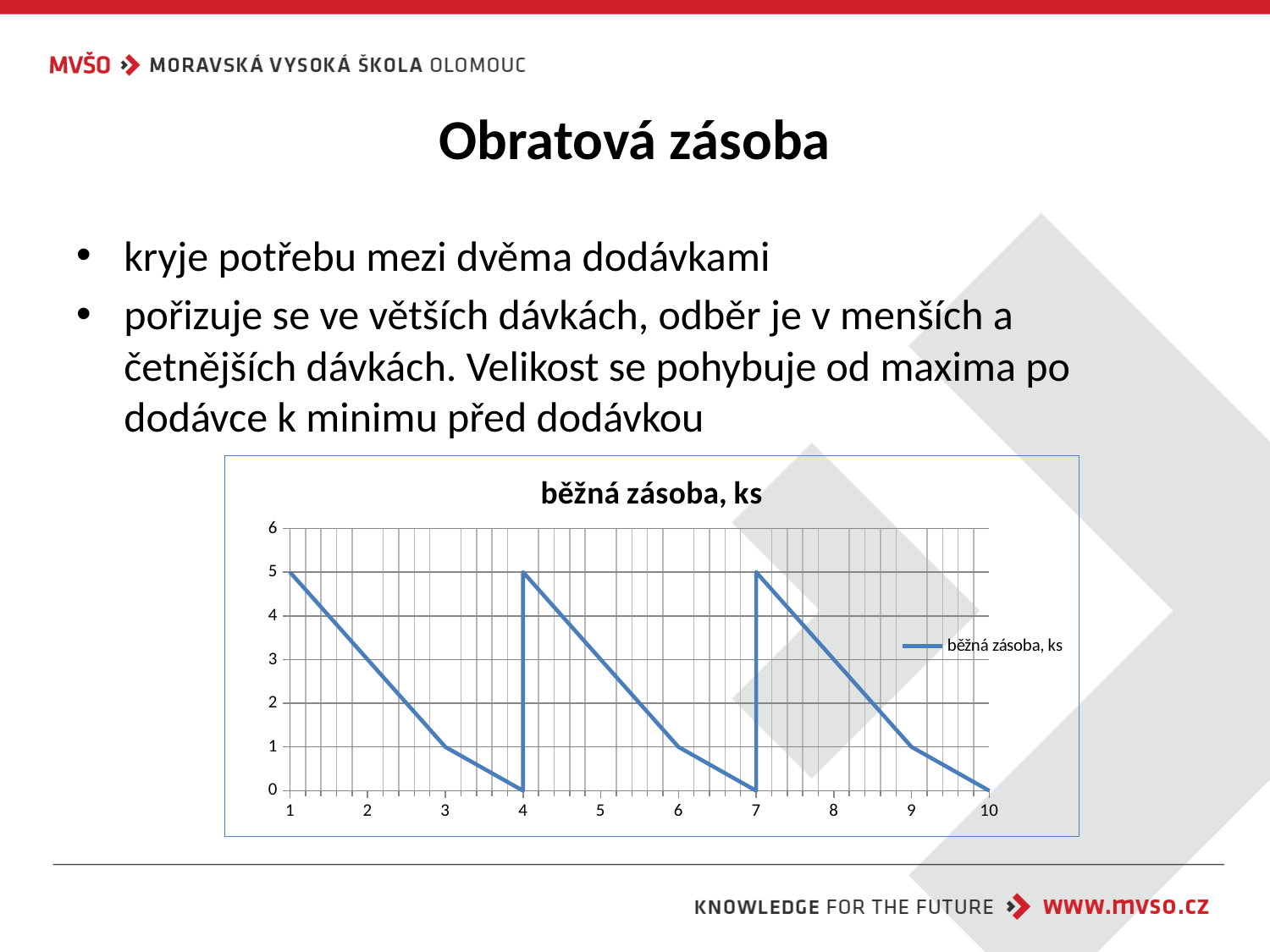
How many points are labelled on the x axis? 10 How many series does the legend list? 1 Which is larger, the value at x = 5 or the value at x = 6? x = 5 What is the title of the chart? běžná zásoba, ks What is the value of běžná zásoba at x = 3? 1 What is the value of běžná zásoba at x = 1? 5 What kind of chart is shown on the slide? line chart Does the value rise or fall from x = 8 to x = 10? fall What is the value of běžná zásoba at x = 2? 3 What is the highest value shown on the y axis? 6 What is the value of běžná zásoba at x = 10? 0 What is the difference between the value at x = 1 and the value at x = 3? 4